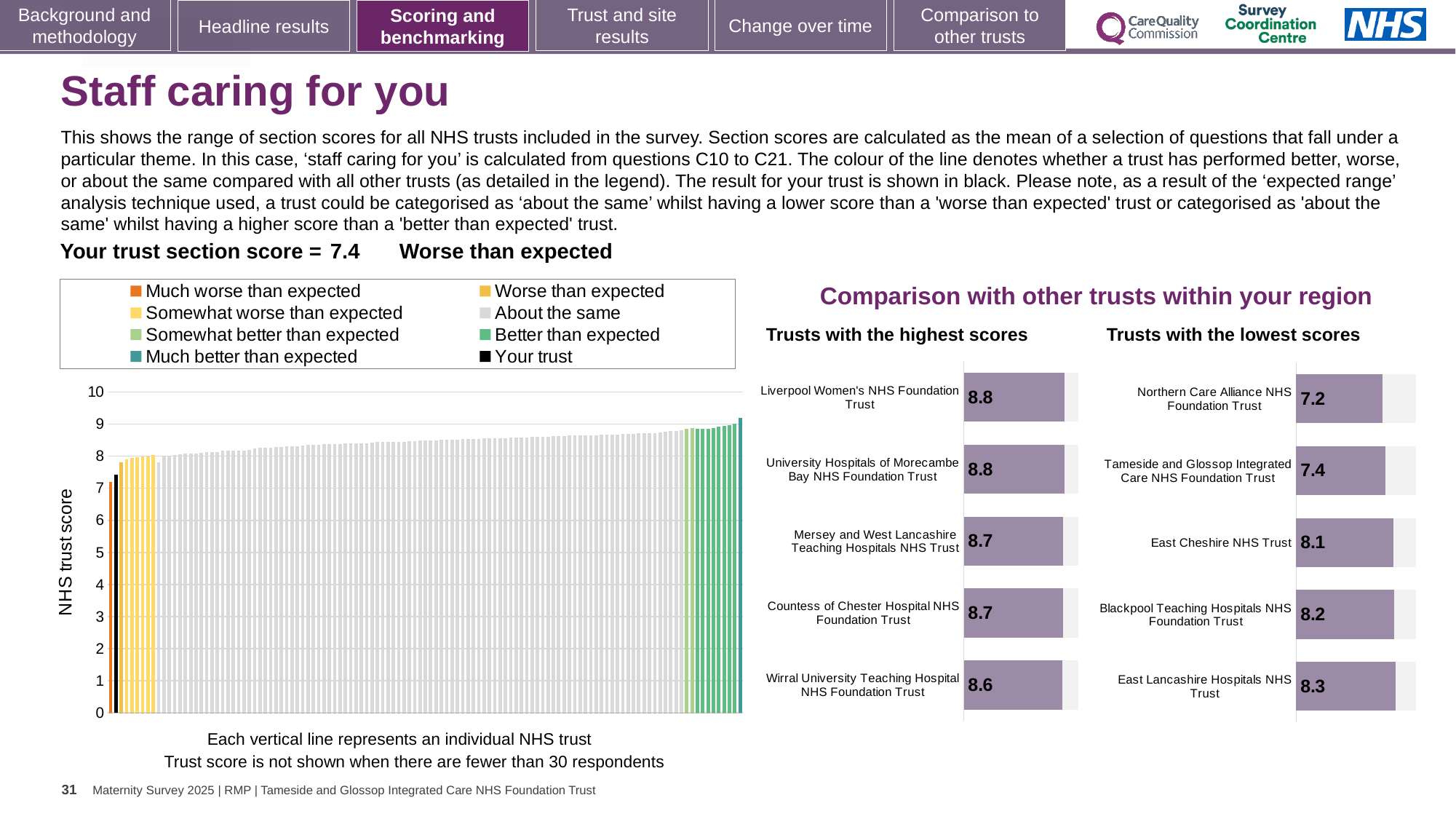
In the 'Trusts with the lowest scores' chart, what is the difference between the scores of East Lancashire Hospitals NHS Trust and Northern Care Alliance NHS Foundation Trust? 1.1 In the 'Trusts with the lowest scores' chart, which has the higher score: East Cheshire NHS Trust or Blackpool Teaching Hospitals NHS Foundation Trust? Blackpool Teaching Hospitals NHS Foundation Trust In the 'Trusts with the lowest scores' chart, what is the score for East Lancashire Hospitals NHS Trust? 8.3 In the 'Trusts with the highest scores' chart, what is the score for Liverpool Women's NHS Foundation Trust? 8.8 How many trusts are shown in the 'Trusts with the highest scores' chart? 5 In the 'Trusts with the lowest scores' chart, which trust has the lowest score? Northern Care Alliance NHS Foundation Trust How many entries does the legend of the main 'NHS trust score' chart on the left list? 8 In the main chart on the left, is the value of the black 'Your trust' bar greater or less than 8? less What kind of chart is the main chart on the left showing NHS trust scores? Bar chart In the 'Trusts with the highest scores' chart, what is the score for Wirral University Teaching Hospital NHS Foundation Trust? 8.6 In the 'Trusts with the highest scores' chart, what is the difference between the scores of Liverpool Women's NHS Foundation Trust and Wirral University Teaching Hospital NHS Foundation Trust? 0.2 In the 'Trusts with the lowest scores' chart, what is the score for Northern Care Alliance NHS Foundation Trust? 7.2